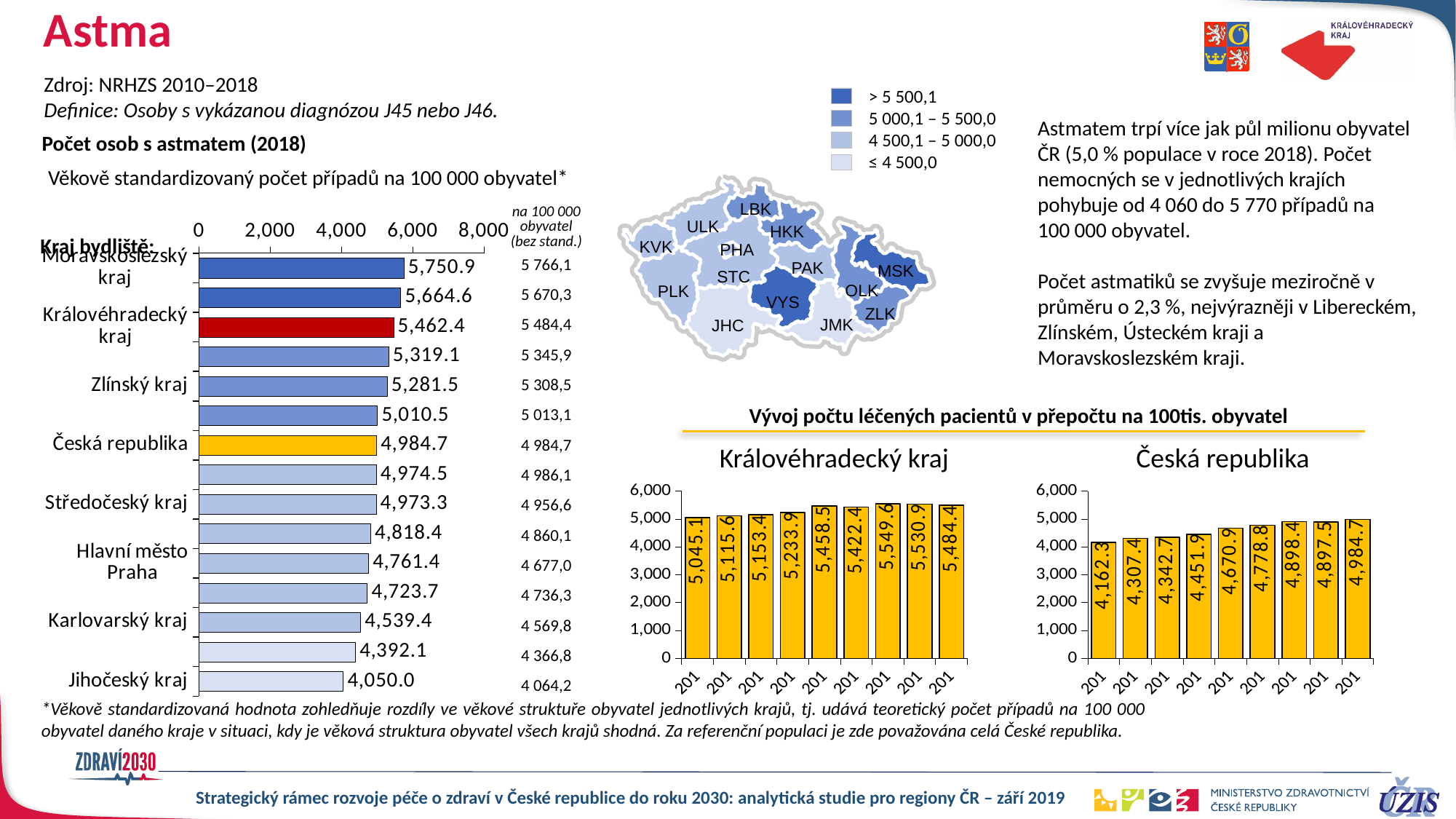
In the 'Královéhradecký kraj' chart at the bottom, what is the value of the first (leftmost) bar? 5,045.1 What kind of chart is the 'Královéhradecký kraj' chart at the bottom of the slide? Bar chart How many bars are plotted in the left bar chart of age-standardized asthma cases? 15 In the 'Česká republika' chart at the bottom right, do the values generally rise or fall from left to right? Rise In the left bar chart of age-standardized asthma cases, which region has the lowest value? Jihočeský kraj In the left bar chart of age-standardized asthma cases per 100 000 inhabitants, what is the value for Královéhradecký kraj? 5,462.4 In the left bar chart of age-standardized asthma cases, which has the larger value: Zlínský kraj or Středočeský kraj? Zlínský kraj In the 'Královéhradecký kraj' chart at the bottom, what is the highest value shown? 5,549.6 In the left bar chart of age-standardized asthma cases, what is the difference between the values for Moravskoslezský kraj and Královéhradecký kraj? 288.5 In the left bar chart of age-standardized asthma cases, what colour is the bar for Královéhradecký kraj? Red In the left bar chart of age-standardized asthma cases, what is the value for Česká republika? 4,984.7 In the left bar chart of age-standardized asthma cases, which region has the highest value? Moravskoslezský kraj